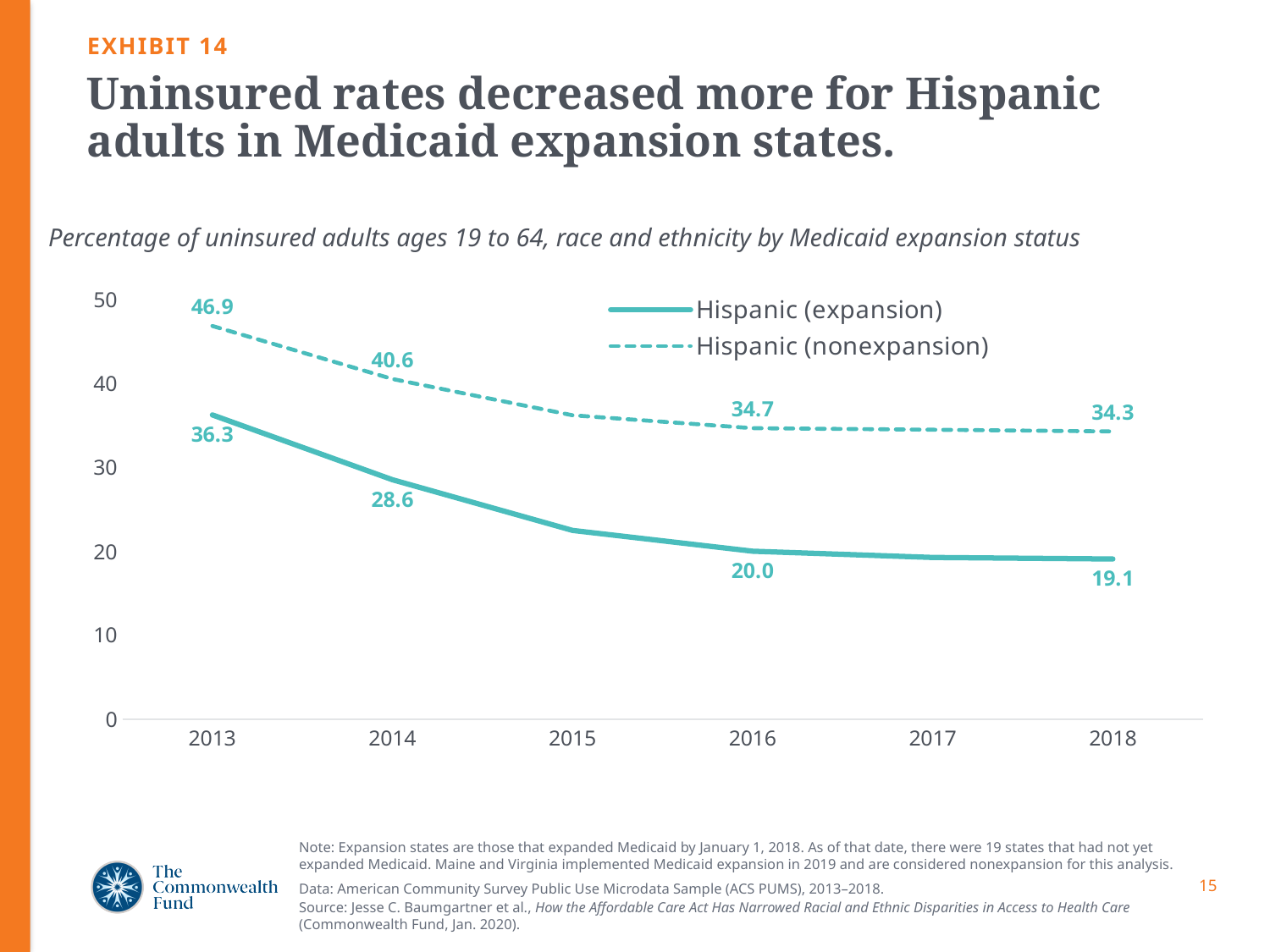
Which series has the larger value in 2016, Hispanic (expansion) or Hispanic (nonexpansion)? Hispanic (nonexpansion) In which year is the Hispanic (expansion) series lowest? 2018 In which year is the Hispanic (nonexpansion) series highest? 2013 How many years are shown on the x axis? 6 What kind of chart is shown on the slide? line chart What is the value for Hispanic (nonexpansion) in 2018? 34.3 Is the value for Hispanic (expansion) in 2015 greater or less than 30? less What is the difference between the Hispanic (nonexpansion) and Hispanic (expansion) values in 2018? 15.2 What is the value for Hispanic (expansion) in 2016? 20.0 What is the value for Hispanic (expansion) in 2013? 36.3 What is the value for Hispanic (nonexpansion) in 2014? 40.6 How many series does the legend list? 2